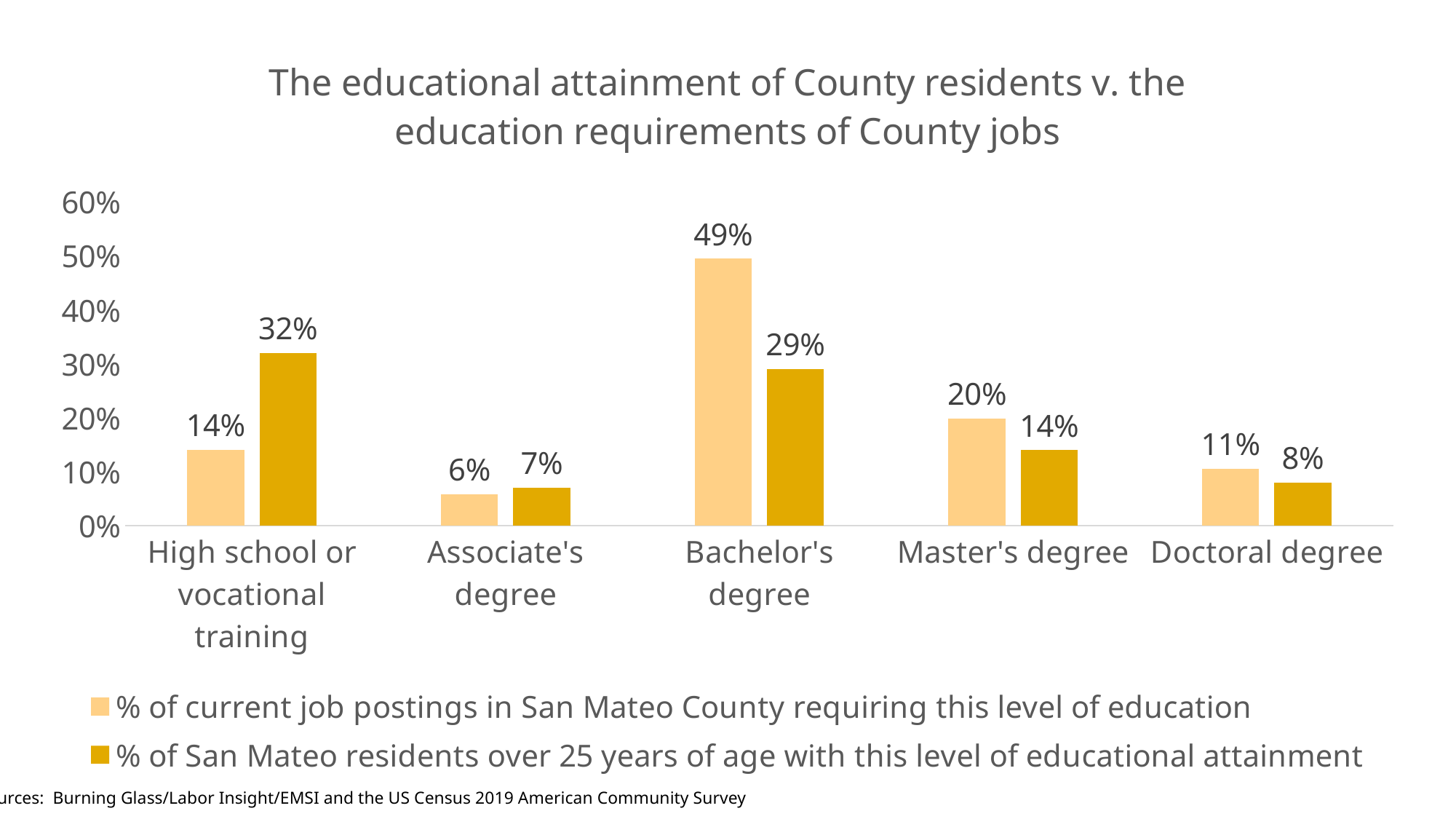
What percentage of San Mateo residents over 25 have a Doctoral degree? 8% What is the title of the chart? The educational attainment of County residents v. the education requirements of County jobs How many series does the legend list? 2 What percentage of San Mateo residents over 25 have a high school or vocational training level of educational attainment? 32% For Master's degree, which is larger: the share of job postings requiring it or the share of residents with it? % of current job postings in San Mateo County requiring this level of education What percentage of current job postings in San Mateo County require a Bachelor's degree? 49% What kind of chart is shown on the slide? Bar chart How many education levels are shown on the x axis? 5 Which education level has the highest share of current job postings requiring it? Bachelor's degree What is the difference between the share of job postings requiring a Bachelor's degree and the share of residents with a Bachelor's degree? 20% What is the difference between the share of residents with high school or vocational training and the share of job postings requiring it? 18% Which education level has the lowest share of San Mateo residents over 25 with that attainment? Associate's degree